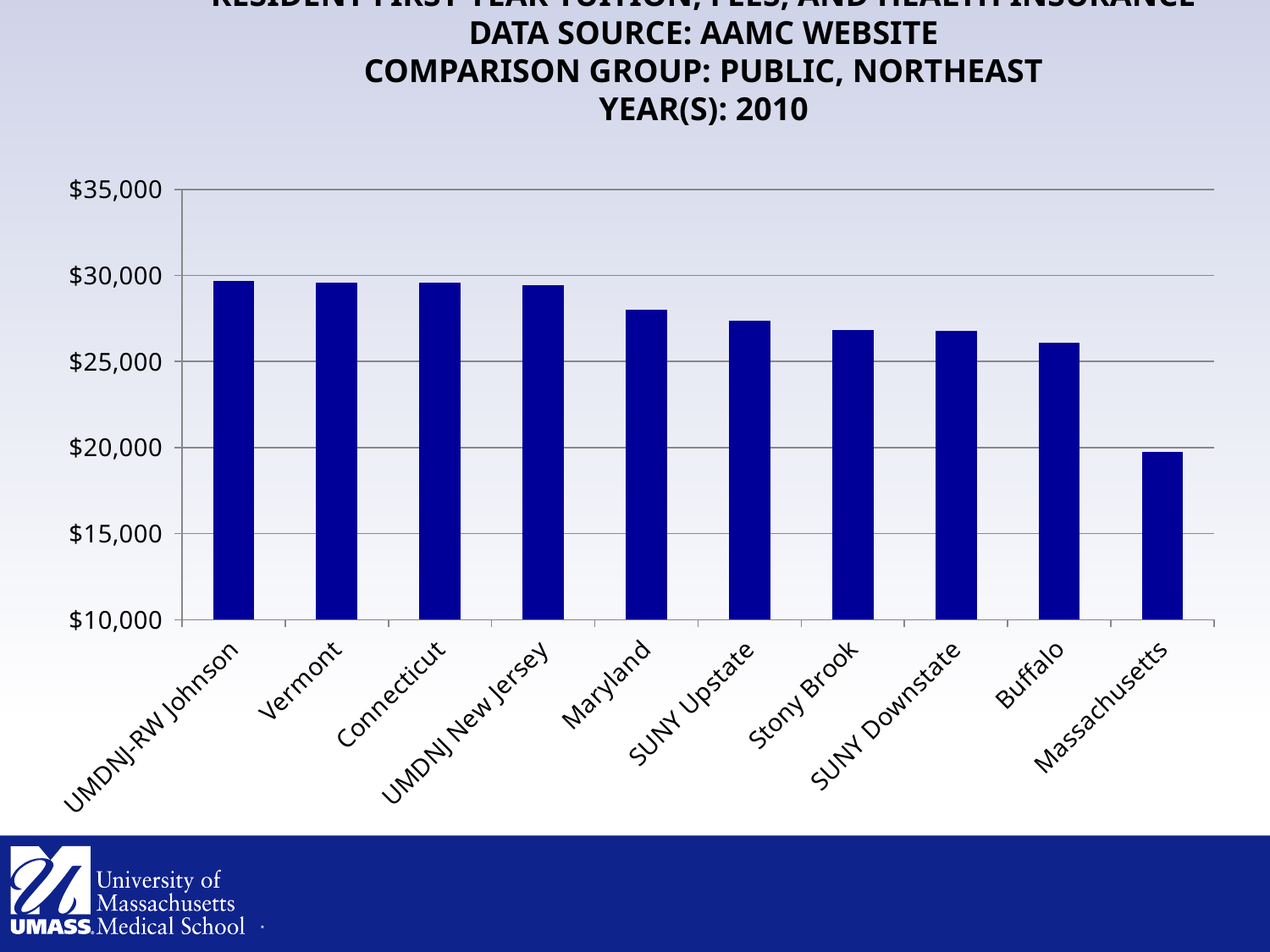
Is the value for Massachusetts greater or less than $20,000? less What kind of chart is shown on the slide? Bar chart Is the value for Buffalo greater or less than $25,000? greater What comparison group does the chart title name? Public, Northeast How many schools are shown on the x axis of the chart? 10 What year does the chart title say the data is for? 2010 Is the value for Maryland greater or less than $25,000? greater Which school has the lowest resident first-year tuition, fees, and health insurance in the chart? Massachusetts Do the values generally rise or fall moving from left to right along the x axis? Fall Which is larger, the value for Vermont or the value for Buffalo? Vermont Which is larger, the value for Maryland or the value for Massachusetts? Maryland